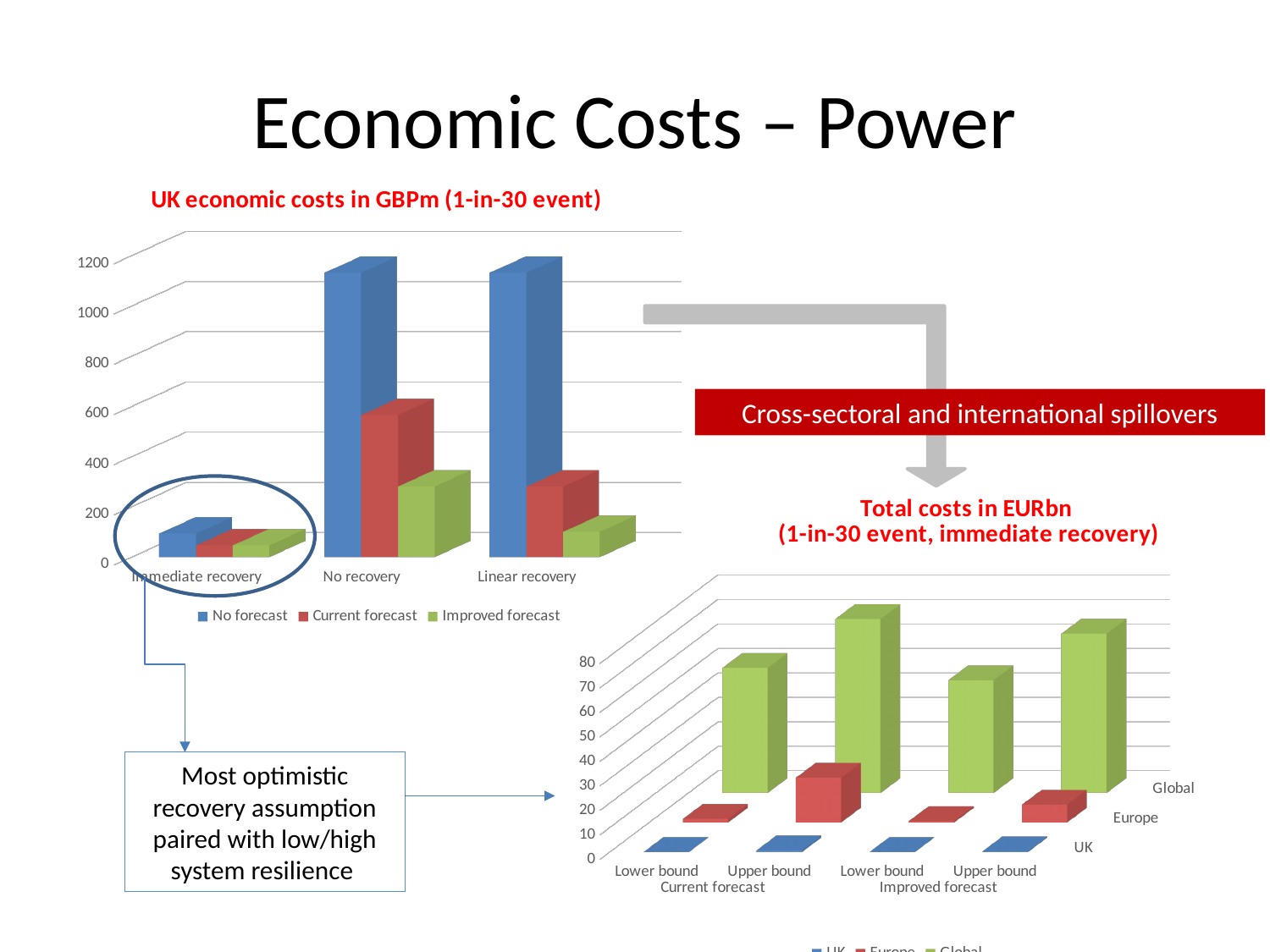
What kind of chart is the 'UK economic costs in GBPm (1-in-30 event)' chart? Bar chart In the 'UK economic costs in GBPm (1-in-30 event)' chart, which is larger for No recovery: No forecast or Current forecast? No forecast How many recovery categories are shown on the x axis of the 'UK economic costs in GBPm (1-in-30 event)' chart? 3 In the 'UK economic costs in GBPm (1-in-30 event)' chart, which series has the highest value for No recovery? No forecast In the 'Total costs in EURbn (1-in-30 event, immediate recovery)' chart, which series has the highest value for the Current forecast Upper bound? Global What kind of chart is the 'Total costs in EURbn (1-in-30 event, immediate recovery)' chart? Bar chart In the 'UK economic costs in GBPm (1-in-30 event)' chart, is the No forecast value for No recovery greater or less than 1000? greater How many series does the legend of the 'UK economic costs in GBPm (1-in-30 event)' chart list? 3 In the 'Total costs in EURbn (1-in-30 event, immediate recovery)' chart, is the Global value for the Current forecast Upper bound greater or less than 60? greater In the 'UK economic costs in GBPm (1-in-30 event)' chart, is the No forecast value for Immediate recovery greater or less than 200? less In the 'Total costs in EURbn (1-in-30 event, immediate recovery)' chart, which is larger for Europe: the Current forecast Lower bound or the Current forecast Upper bound? Upper bound In the 'UK economic costs in GBPm (1-in-30 event)' chart, which series has the lowest value for Linear recovery? Improved forecast